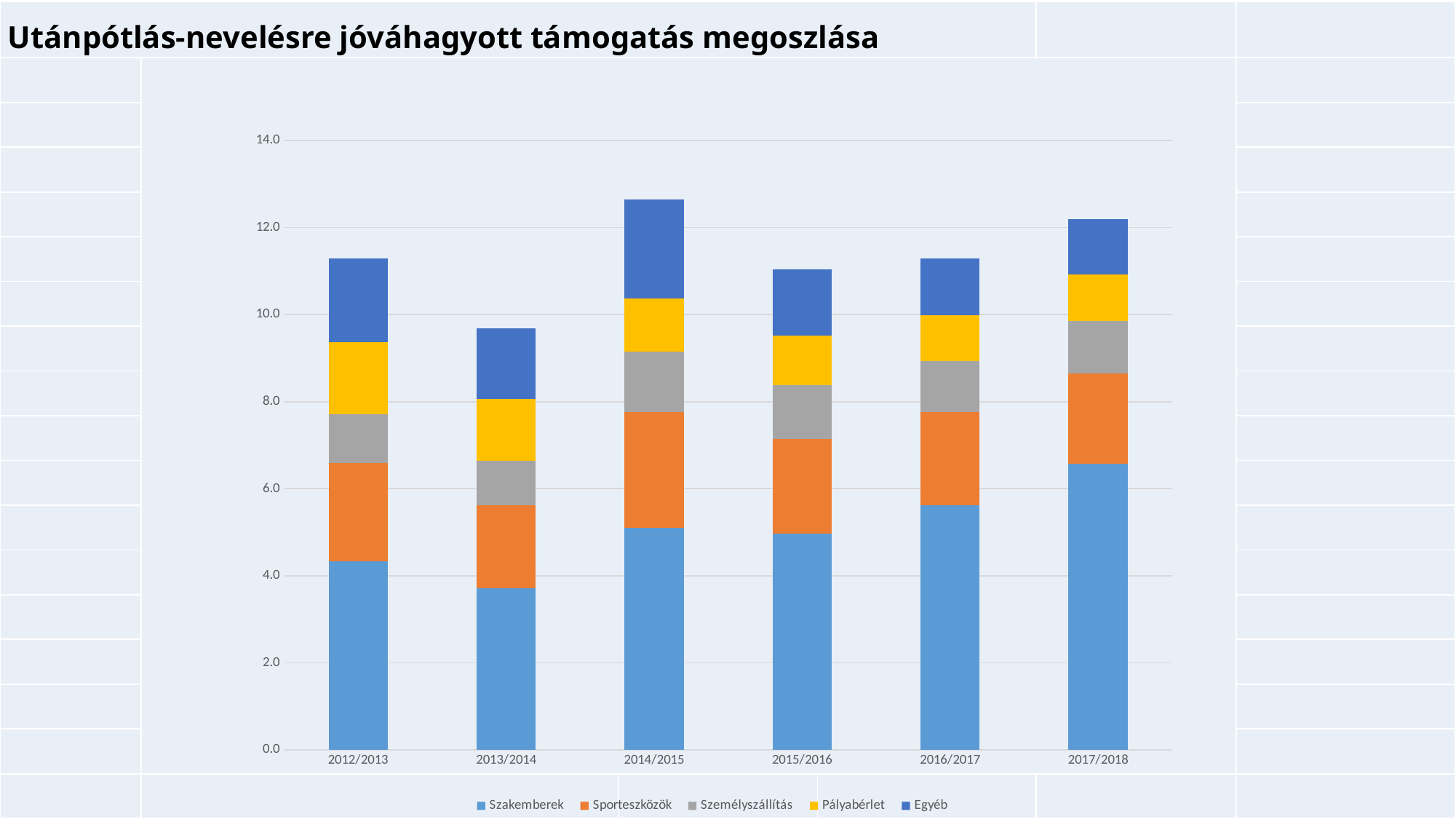
Is the Szakemberek value for 2017/2018 greater or less than 6.0? greater Is the total for 2013/2014 greater or less than 10.0? less How many seasons (categories) are shown on the x axis? 6 Which season has the highest total stacked bar? 2014/2015 How many series does the legend list? 5 Which season has the larger total, 2012/2013 or 2013/2014? 2012/2013 What kind of chart is shown on the slide? Stacked bar chart Which season has the lowest total stacked bar? 2013/2014 Is the Szakemberek value for 2013/2014 greater or less than 4.0? less What is the title of the chart? Utánpótlás-nevelésre jóváhagyott támogatás megoszlása Which season has the larger Szakemberek segment, 2012/2013 or 2017/2018? 2017/2018